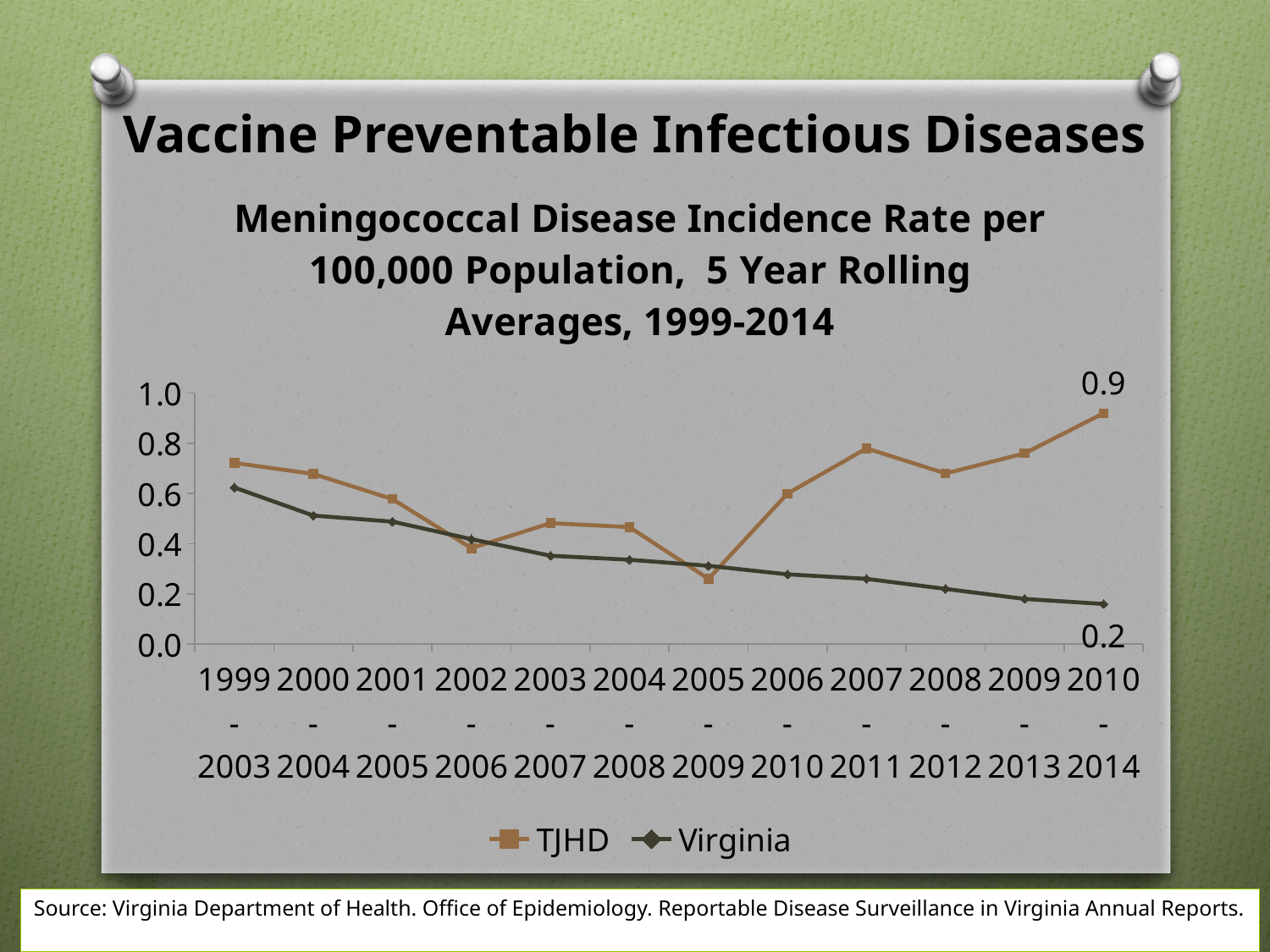
Does the Virginia series rise or fall across the periods from 1999-2003 to 2010-2014? fall What is the difference between the TJHD and Virginia values for the 2010-2014 period? 0.7 Is the Virginia value for the 2009-2013 period greater or less than 0.4? less What is the Virginia value for the 2010-2014 period? 0.2 Which series has the larger value for the 2010-2014 period, TJHD or Virginia? TJHD What is the TJHD value for the 2010-2014 period? 0.9 Is the TJHD value for the 2007-2011 period greater or less than 0.6? greater How many series does the legend list? 2 What kind of chart is shown on the slide? line chart What are the two series named in the legend? TJHD and Virginia In which period is the TJHD value lowest? 2005-2009 How many time periods are plotted along the x axis? 12